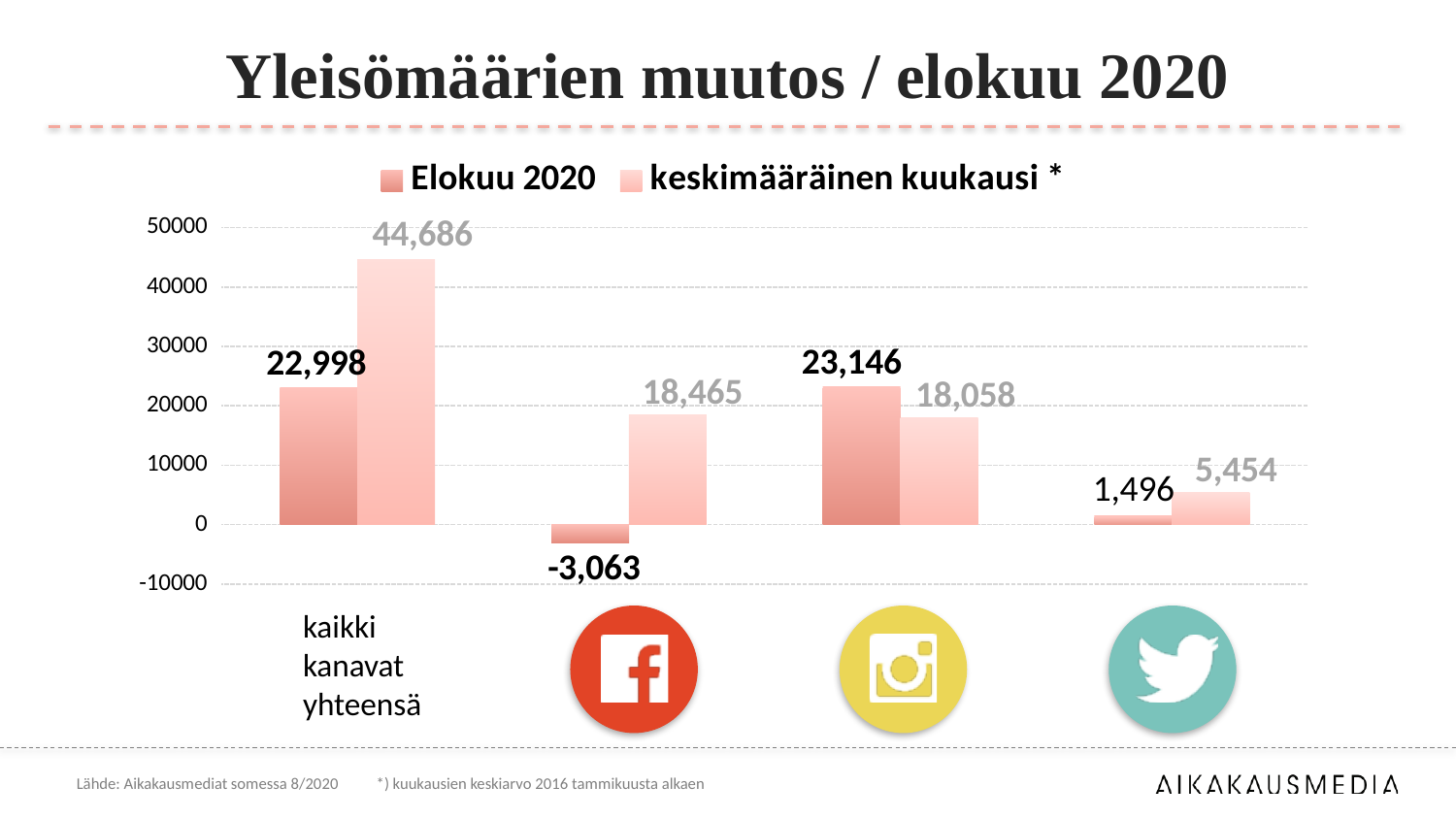
What is the keskimääräinen kuukausi value for the Instagram category? 18,058 What is the difference between the keskimääräinen kuukausi and Elokuu 2020 values for kaikki kanavat yhteensä? 21,688 What is the keskimääräinen kuukausi value for kaikki kanavat yhteensä? 44,686 Which category has the lowest Elokuu 2020 value? Facebook What is the Elokuu 2020 value for kaikki kanavat yhteensä? 22,998 What is the Elokuu 2020 value for the Twitter category? 1,496 How many categories are shown on the x axis? 4 For the Instagram category, which is larger: the Elokuu 2020 value or the keskimääräinen kuukausi value? Elokuu 2020 Which category has the highest keskimääräinen kuukausi value? kaikki kanavat yhteensä How many series does the legend list? 2 What type of chart is shown on the slide? Bar chart What is the Elokuu 2020 value for the Facebook category? -3,063